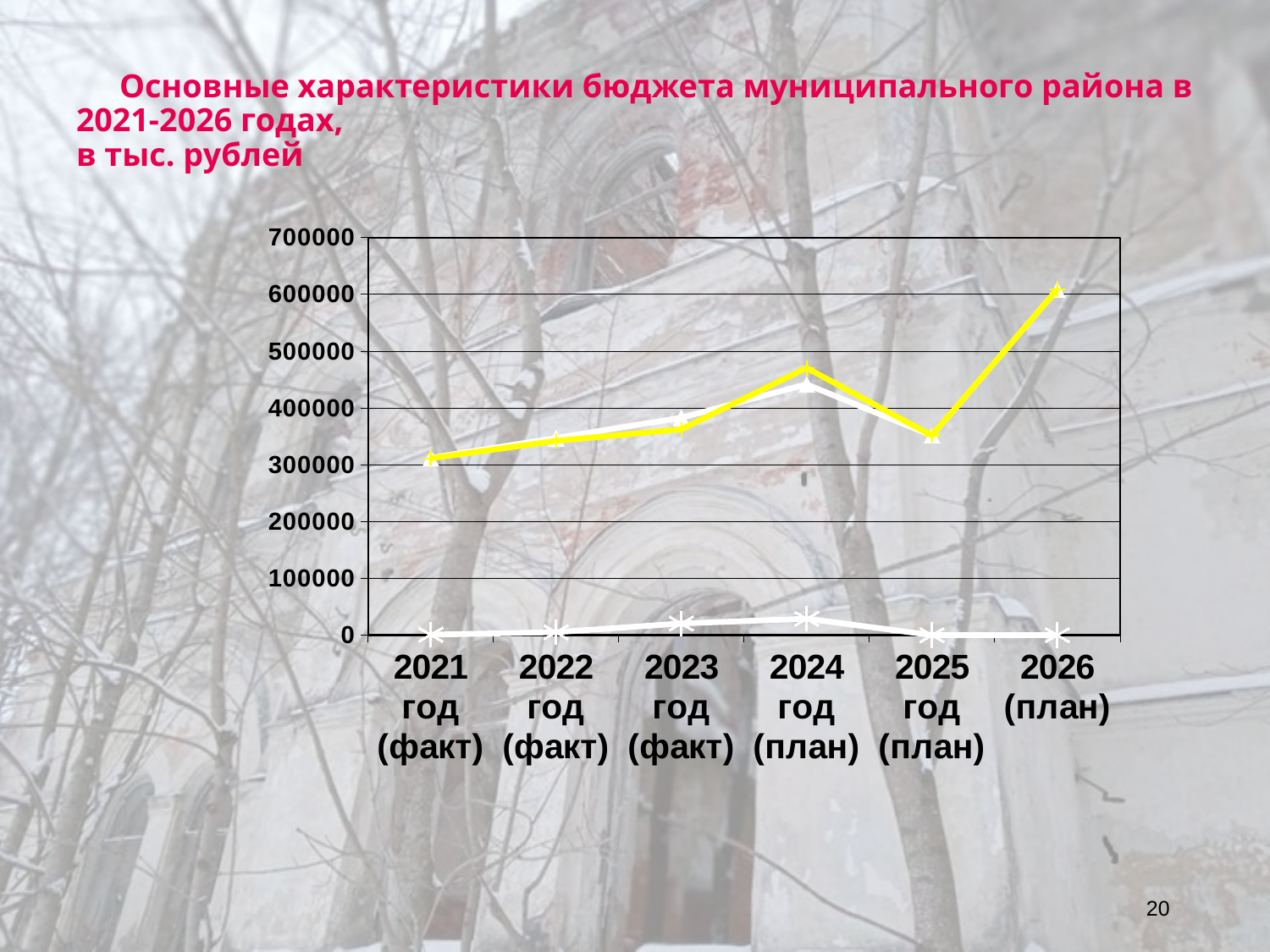
Which is larger for the yellow line: the value for 2024 год (план) or the value for 2025 год (план)? 2024 год (план) Is the value of the yellow line for 2026 (план) greater or less than 500000? greater How many lines are plotted on the chart? 3 In which year does the yellow line have its lowest value? 2021 год (факт) Does the yellow line rise or fall between 2025 год (план) and 2026 (план)? rise Is the value of the white line with star markers for 2024 год (план) greater or less than 100000? less What is the highest value shown on the vertical axis of the chart? 700000 Is the value of the yellow line for 2025 год (план) greater or less than 400000? less How many categories (years) are shown on the x axis of the chart? 6 In which year does the yellow line reach its highest value? 2026 (план) What kind of chart is shown on the slide? line chart